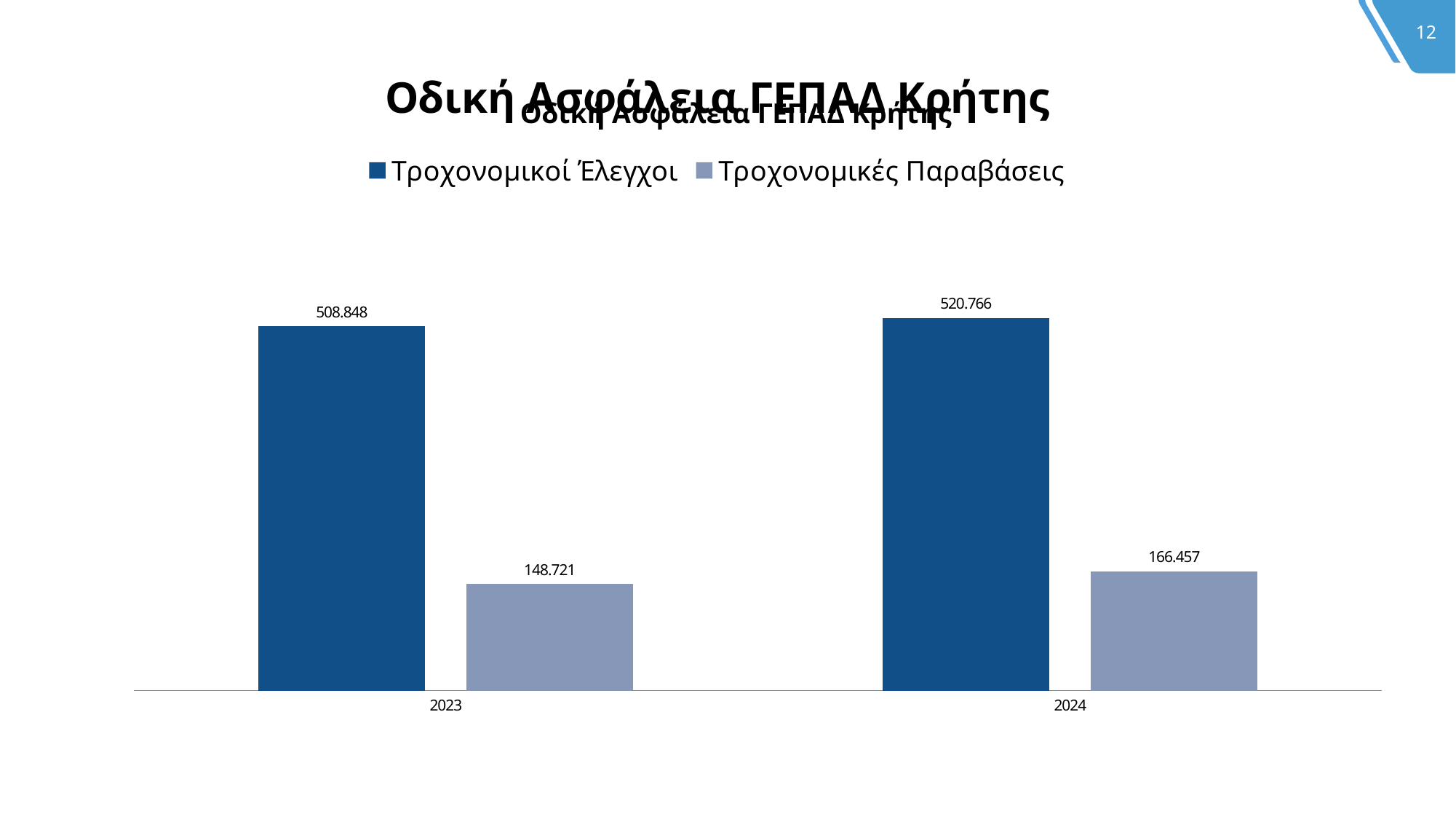
What is the value of Τροχονομικοί Έλεγχοι for 2023? 508.848 What kind of chart is shown on the slide? Bar chart What is the difference between Τροχονομικοί Έλεγχοι in 2024 and in 2023? 11.918 What is the value of Τροχονομικοί Έλεγχοι for 2024? 520.766 What is the value of Τροχονομικές Παραβάσεις for 2024? 166.457 What is the difference between Τροχονομικές Παραβάσεις in 2024 and in 2023? 17.736 How many series does the legend list? 2 Which year has the lower value for Τροχονομικές Παραβάσεις? 2023 Which is larger in 2023: Τροχονομικοί Έλεγχοι or Τροχονομικές Παραβάσεις? Τροχονομικοί Έλεγχοι How many years are shown on the x axis? 2 What is the value of Τροχονομικές Παραβάσεις for 2023? 148.721 Which year has the higher value for Τροχονομικοί Έλεγχοι? 2024